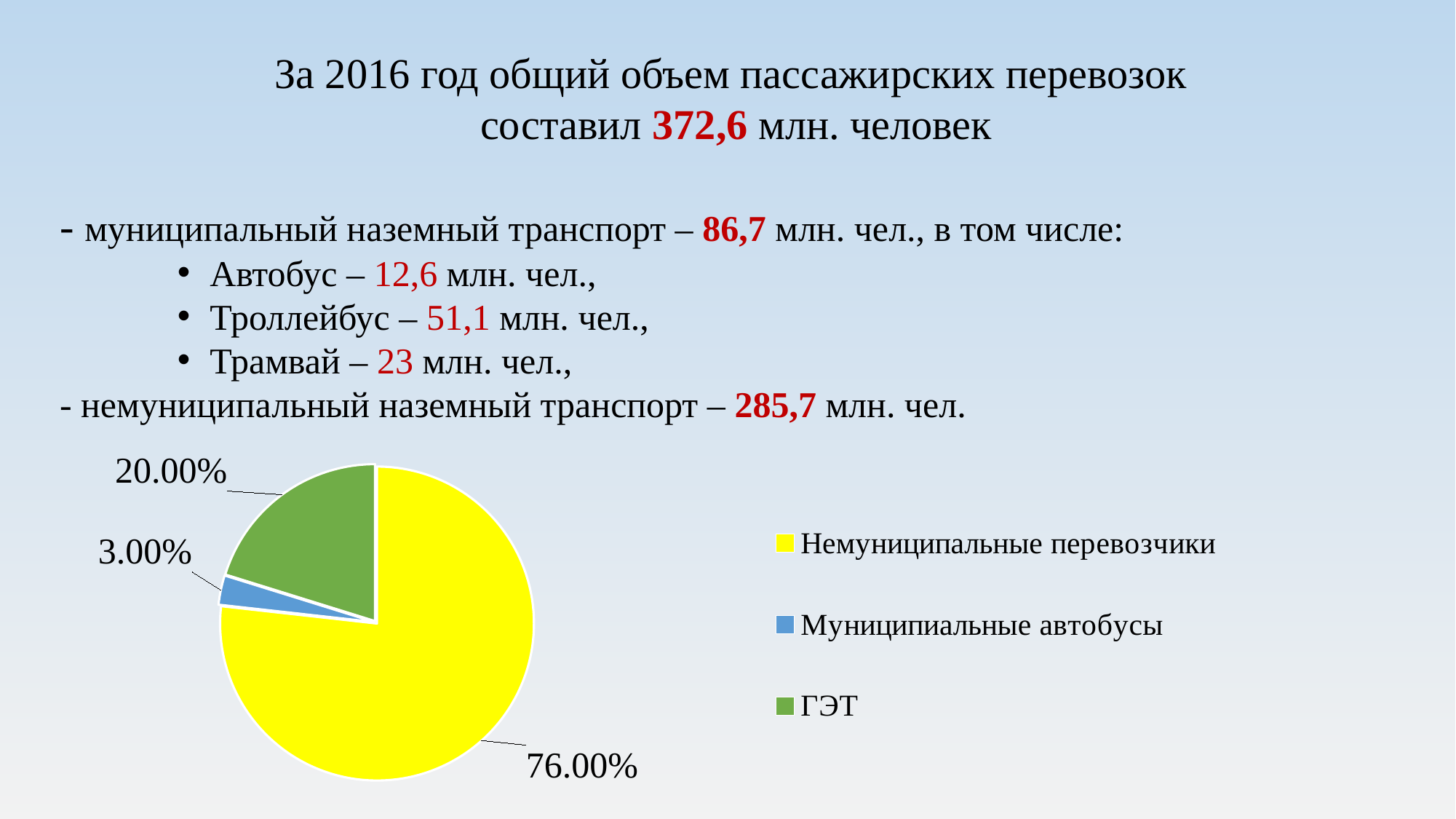
Which category has the largest slice of the pie? Немуниципальные перевозчики What is the difference in percentage points between the ГЭТ slice and the Муниципиальные автобусы slice? 17.00% What colour is the slice for Немуниципальные перевозчики? yellow How many slices does the pie chart have? 3 Which slice is larger: ГЭТ or Муниципиальные автобусы? ГЭТ What share of the pie does Немуниципальные перевозчики have? 76.00% What kind of chart is shown on the slide? pie chart What share of the pie does Муниципиальные автобусы have? 3.00% What share of the pie does ГЭТ have? 20.00% What is the difference in percentage points between the Немуниципальные перевозчики slice and the ГЭТ slice? 56.00% Which category has the smallest slice of the pie? Муниципиальные автобусы How many entries does the legend list? 3